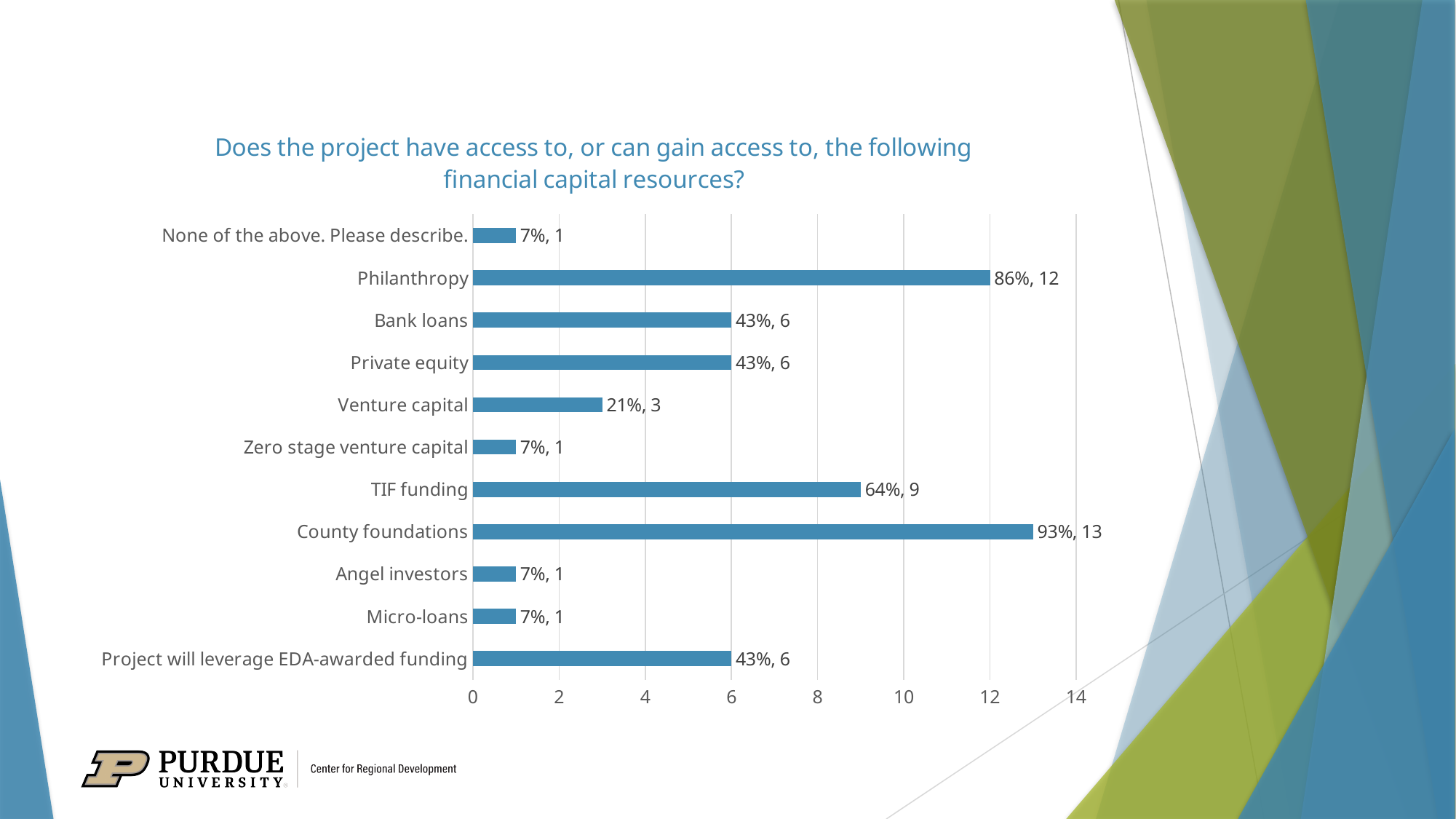
How many categories have a value of 7%, 1? 4 What is the data label shown for Philanthropy? 86%, 12 What is the difference in count between County foundations and Philanthropy? 1 What is the title of the chart? Does the project have access to, or can gain access to, the following financial capital resources? Which category has the highest value? County foundations What is the data label shown for TIF funding? 64%, 9 What is the difference in count between TIF funding and Bank loans? 3 Which is larger, the value for TIF funding or the value for Private equity? TIF funding Is the value for County foundations greater or less than 12? greater How many categories are shown on the chart? 11 What is the data label shown for Venture capital? 21%, 3 What kind of chart is shown on the slide? bar chart